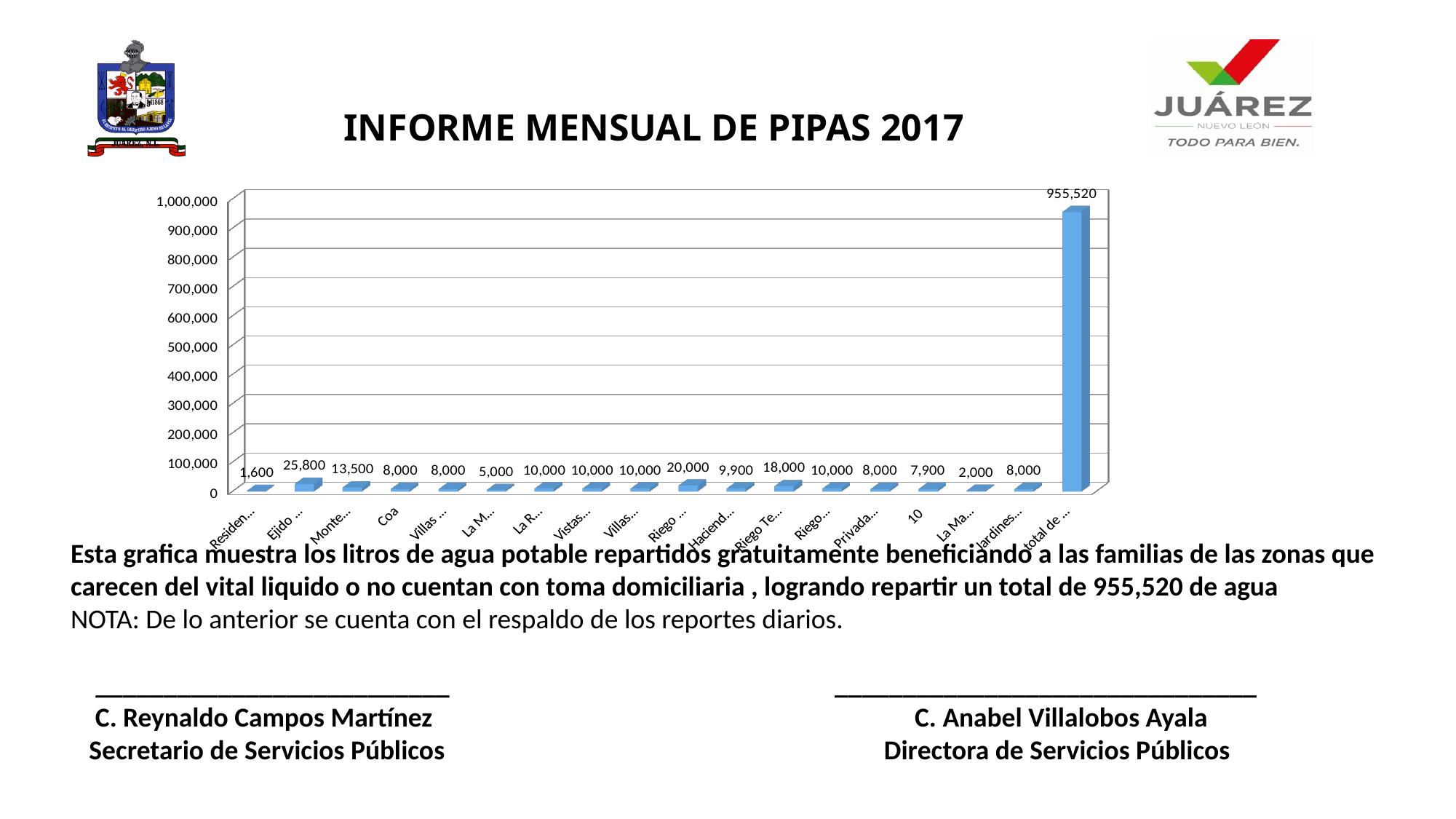
What is the difference between the values for "Coa" and "10"? 100 What is the highest tick value shown on the vertical axis? 1,000,000 Which has the larger value, "Coa" or "10"? Coa How many bars are plotted in the chart? 18 What is the value of the shortest bar in the chart? 1,600 What is the value of the second bar from the left (labelled "Ejido ...")? 25,800 What is the value of the tallest bar in the chart? 955,520 What is the value for the category labelled "Coa"? 8,000 What kind of chart is shown on the slide? bar chart What is the value of the bar labelled "Riego Te..."? 18,000 What is the value for the category labelled "10"? 7,900 Is the value of the last bar on the right ("total de ...") greater or less than 900,000? greater